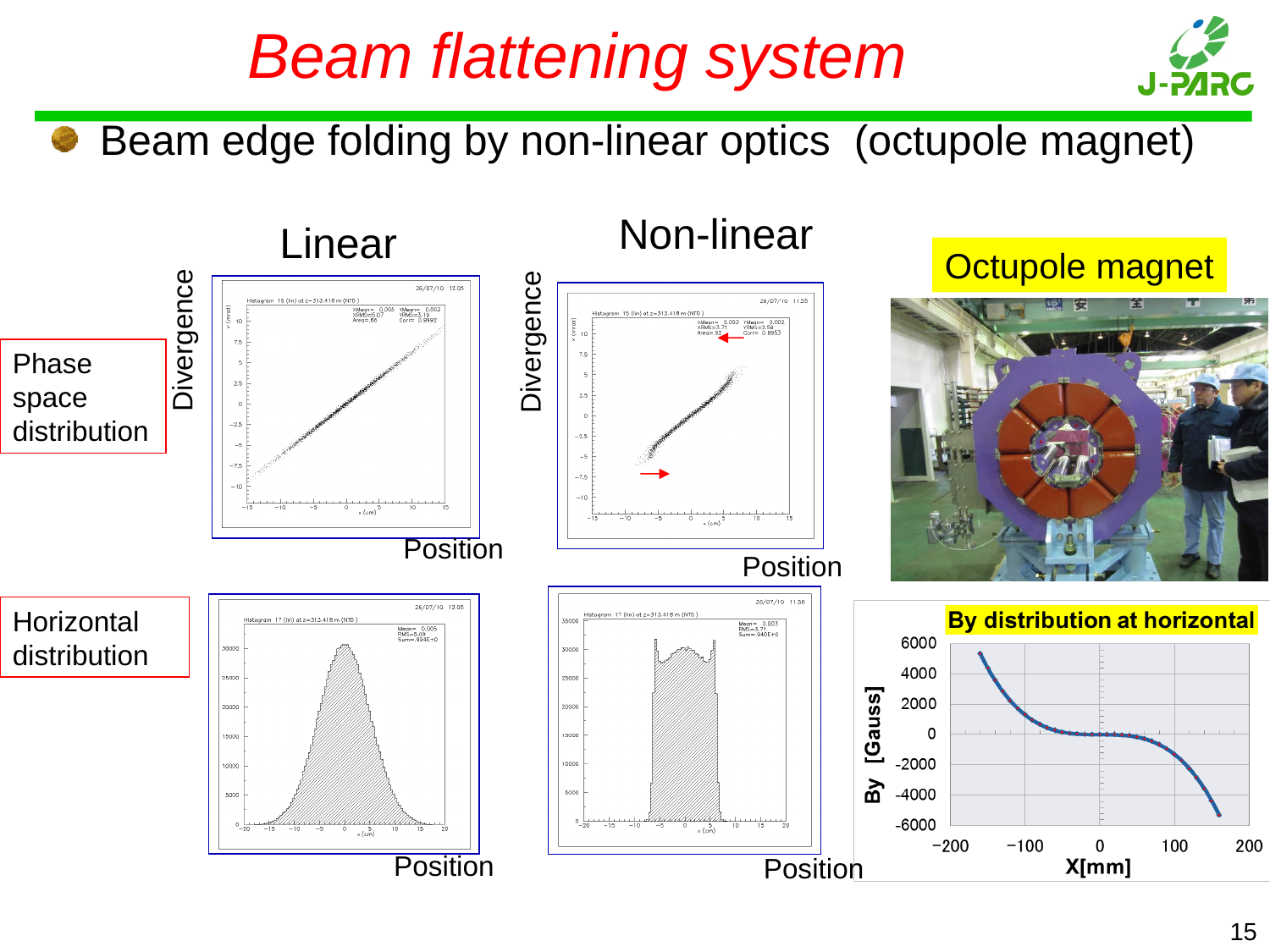
In the Linear horizontal distribution histogram, is the peak value greater or less than 25000? greater What kind of chart is the Linear phase space distribution plot? scatter plot In the 'By distribution at horizontal' chart, is the value of By at X = 50 mm greater or less than -2000? greater In the 'By distribution at horizontal' chart, what is the label of the x axis? X[mm] In the 'By distribution at horizontal' chart, does By rise or fall as X increases from -200 to 200? fall In the 'By distribution at horizontal' chart, is the value of By at X = 150 mm greater or less than -4000? less What is the RMS value printed on the Linear horizontal distribution histogram? 5.09 What kind of chart is the 'By distribution at horizontal' chart? line chart In the 'By distribution at horizontal' chart, what is the label of the y axis? By [Gauss] What is the RMS value printed on the Non-linear horizontal distribution histogram? 3.71